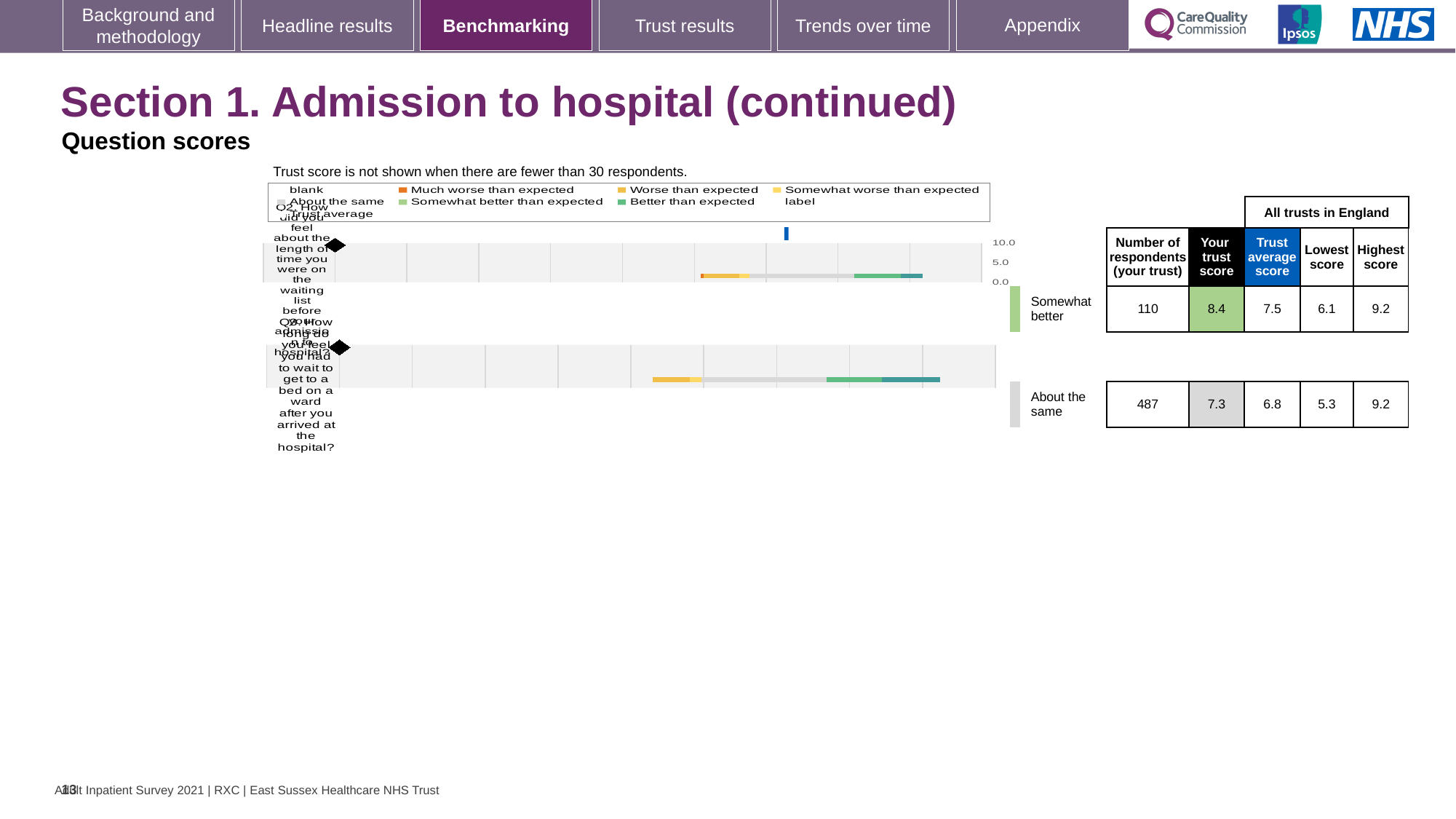
What is the highest score among all trusts in England for Q3? 9.2 What kind of chart is used to show the question scores on this slide? bar chart Which question has the higher trust score, Q2 or Q3? Q2 What is the trust score for Q3 (how long did you feel you had to wait to get to a bed on a ward)? 7.3 How many respondents answered Q3 for this trust? 487 How many questions are plotted in the chart? 2 What is the lowest score among all trusts in England for Q2? 6.1 By how much does the trust score for Q2 exceed the trust average score for Q2? 0.9 What is the trust average score across all trusts in England for Q2? 7.5 What benchmark category is shown for Q2? Somewhat better What is the trust score for Q2 (how did you feel about the length of time on the waiting list)? 8.4 What is the difference between the highest and lowest scores for Q3? 3.9